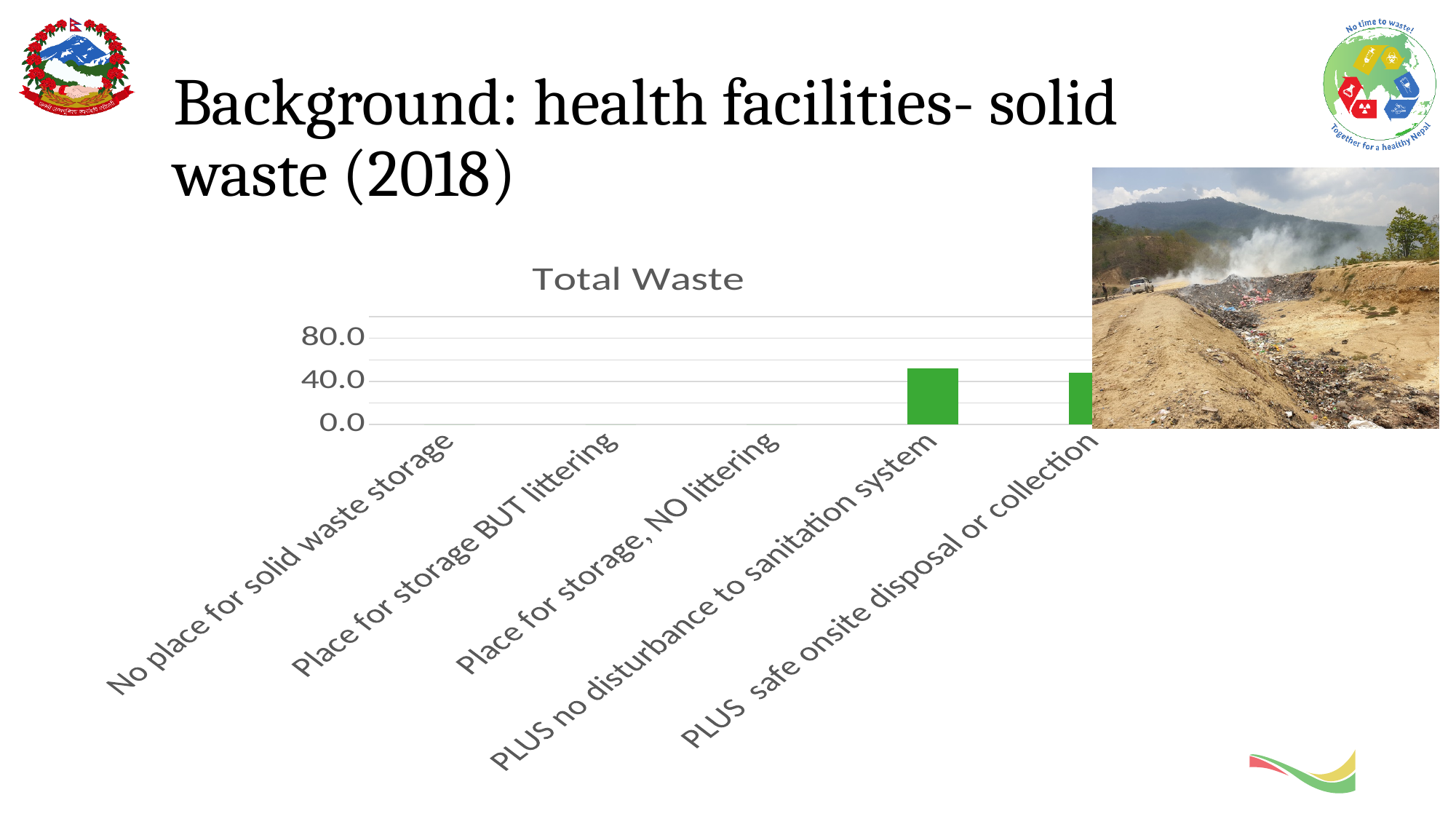
Is the value for "PLUS safe onsite disposal or collection" greater or less than 80? less What is the title of the chart? Total Waste Is the value for "PLUS no disturbance to sanitation system" greater or less than 80? less What colour are the bars in the chart? green How many categories are shown on the x axis of the chart? 5 Is the value for "PLUS safe onsite disposal or collection" greater or less than 40? greater What kind of chart is shown on the slide? bar chart Which is larger, the value for "PLUS no disturbance to sanitation system" or the value for "No place for solid waste storage"? PLUS no disturbance to sanitation system